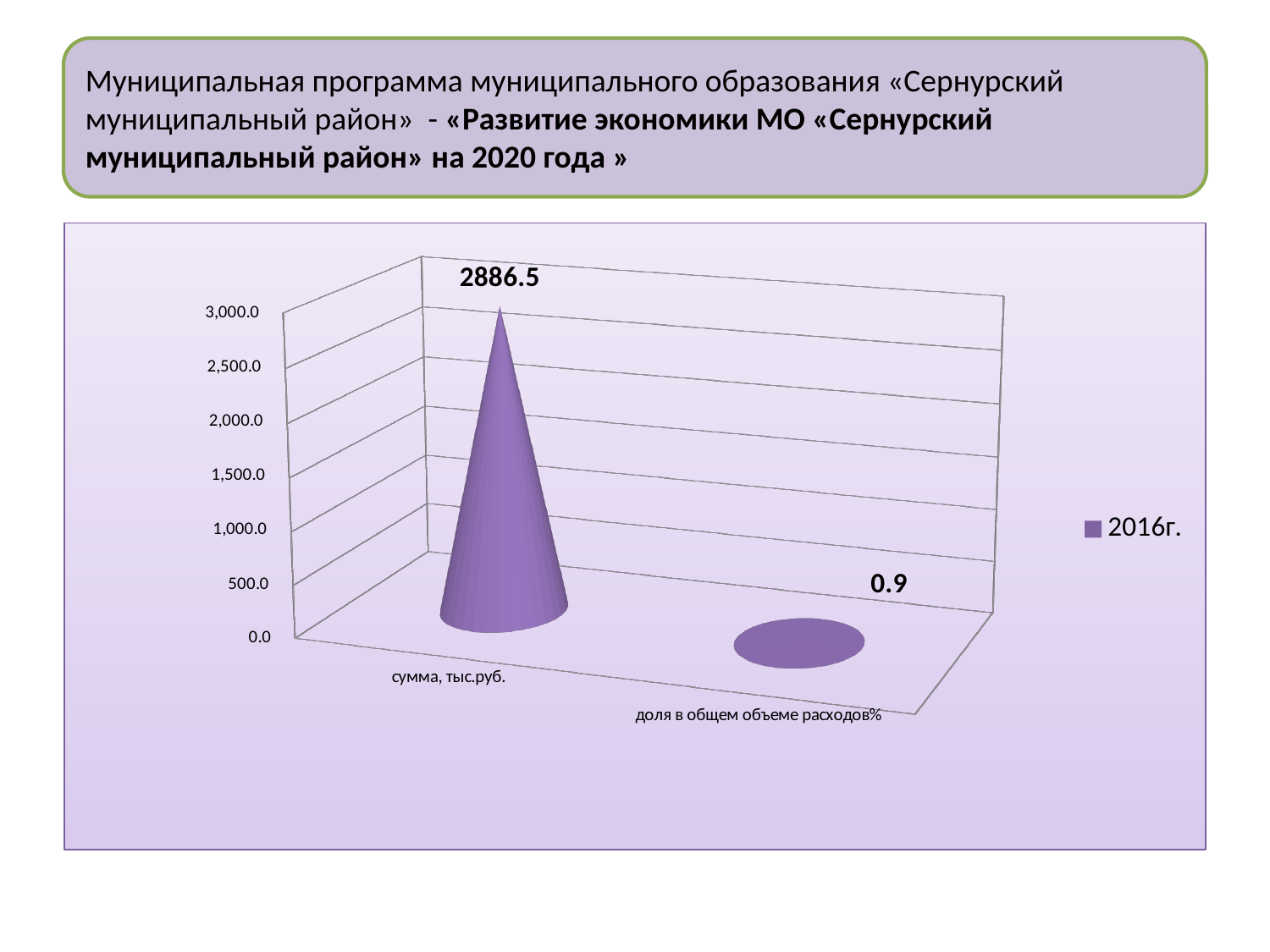
Which category has the lowest value? доля в общем объеме расходов% Which is larger: the value for "сумма, тыс.руб." or the value for "доля в общем объеме расходов%"? сумма, тыс.руб. Is the value for "доля в общем объеме расходов%" greater or less than 500.0? less What is the value for "сумма, тыс.руб."? 2886.5 What is the difference between the values for "сумма, тыс.руб." and "доля в общем объеме расходов%"? 2885.6 Is the value for "сумма, тыс.руб." greater or less than 2,500.0? greater What kind of chart is shown on the slide? bar chart What is the value for "доля в общем объеме расходов%"? 0.9 Which category has the highest value? сумма, тыс.руб. How many categories are shown on the chart? 2 How many series does the legend list? 1 What series name is shown in the chart legend? 2016г.